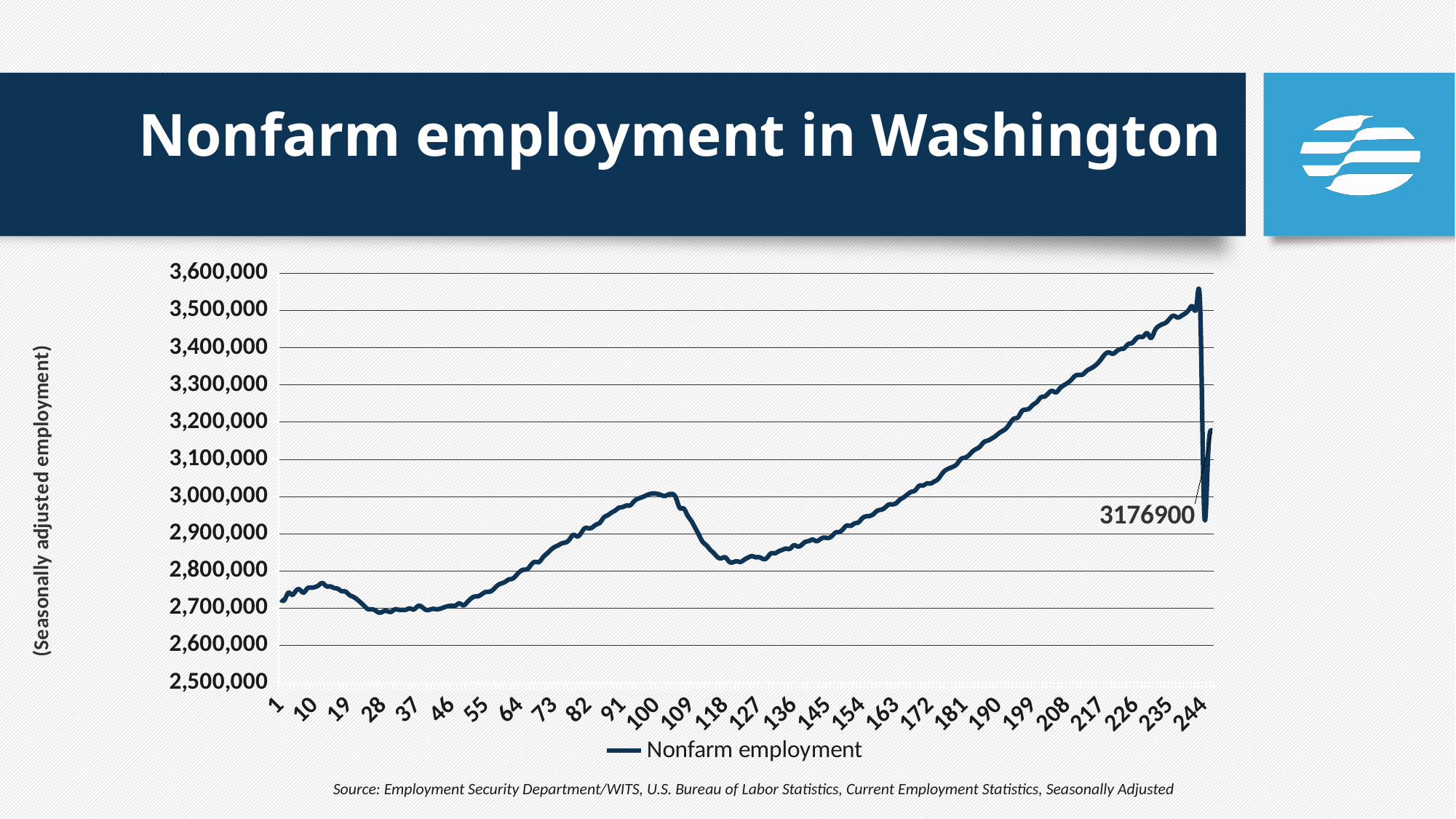
Is the value at point 127 greater or less than 2,900,000? less Is the value at point 1 greater or less than 2,800,000? less What is the label on the vertical axis? (Seasonally adjusted employment) What is the title of the chart? Nonfarm employment in Washington How many series does the legend list? 1 Is the value at point 235 greater or less than 3,400,000? greater What kind of chart is shown on the slide? line chart Between points 136 and 226, does the line rise or fall? rise What is the value shown by the data label at the end of the line? 3176900 Which is larger, the value at point 100 or the value at point 1? point 100 Between points 109 and 118, does the line rise or fall? fall